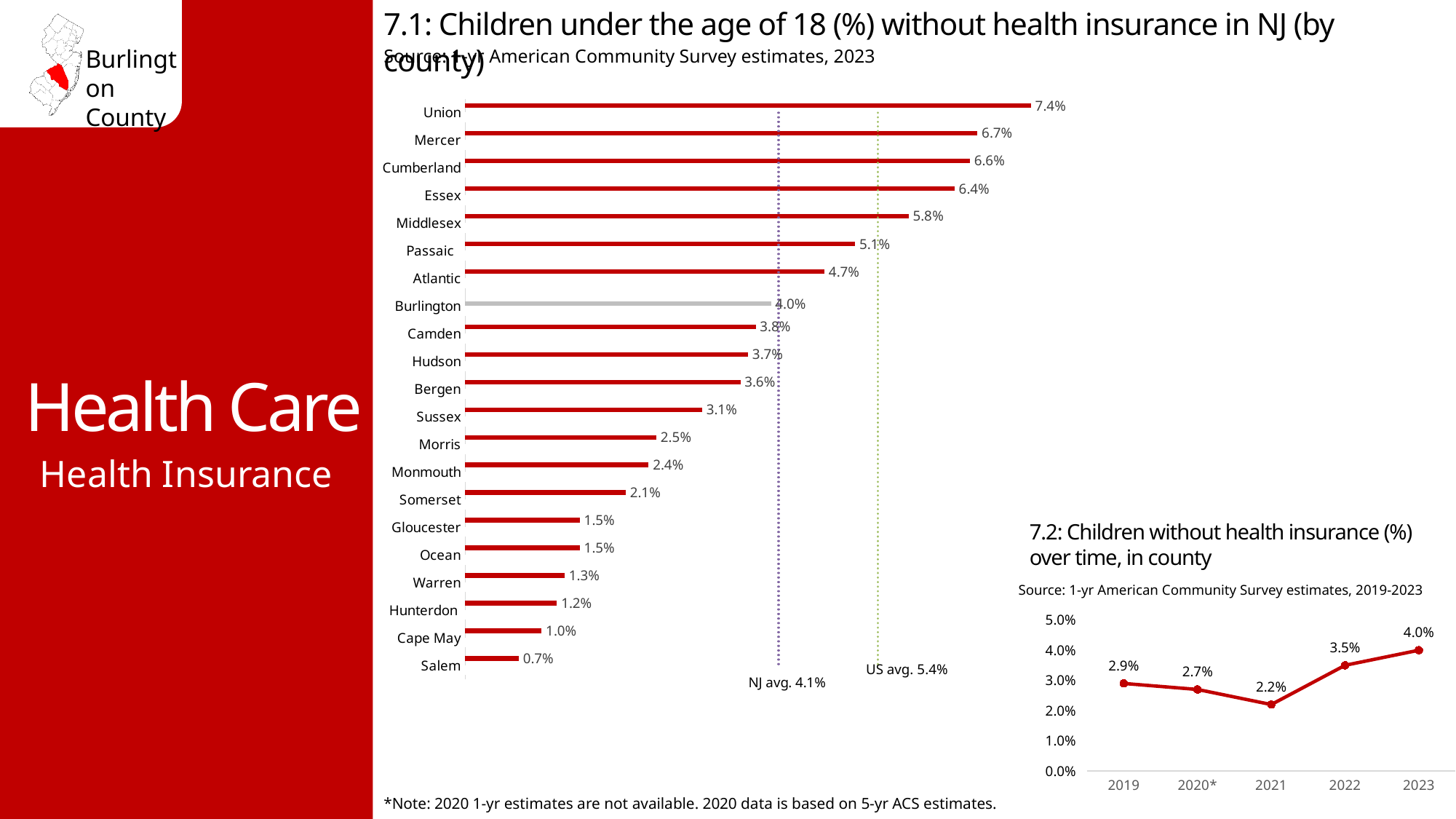
What kind of chart is chart 7.1? Bar chart In chart 7.2 (children without health insurance over time, in county), what is the value for 2021? 2.2% In chart 7.1, what is the difference between the values for Union and Salem? 6.7% What kind of chart is chart 7.2? Line chart In chart 7.1, what is the NJ average shown by the dotted reference line? 4.1% In chart 7.1, which county has a higher value, Mercer or Essex? Mercer In chart 7.1, which county has the highest percentage of children without health insurance? Union In chart 7.1, which county has the lowest percentage of children without health insurance? Salem In chart 7.1, how many counties are shown? 21 In chart 7.1 (children under 18 without health insurance by county), what is the value for Burlington? 4.0% In chart 7.2, which year has the highest value? 2023 In chart 7.2, what is the difference between the 2023 and 2019 values? 1.1%